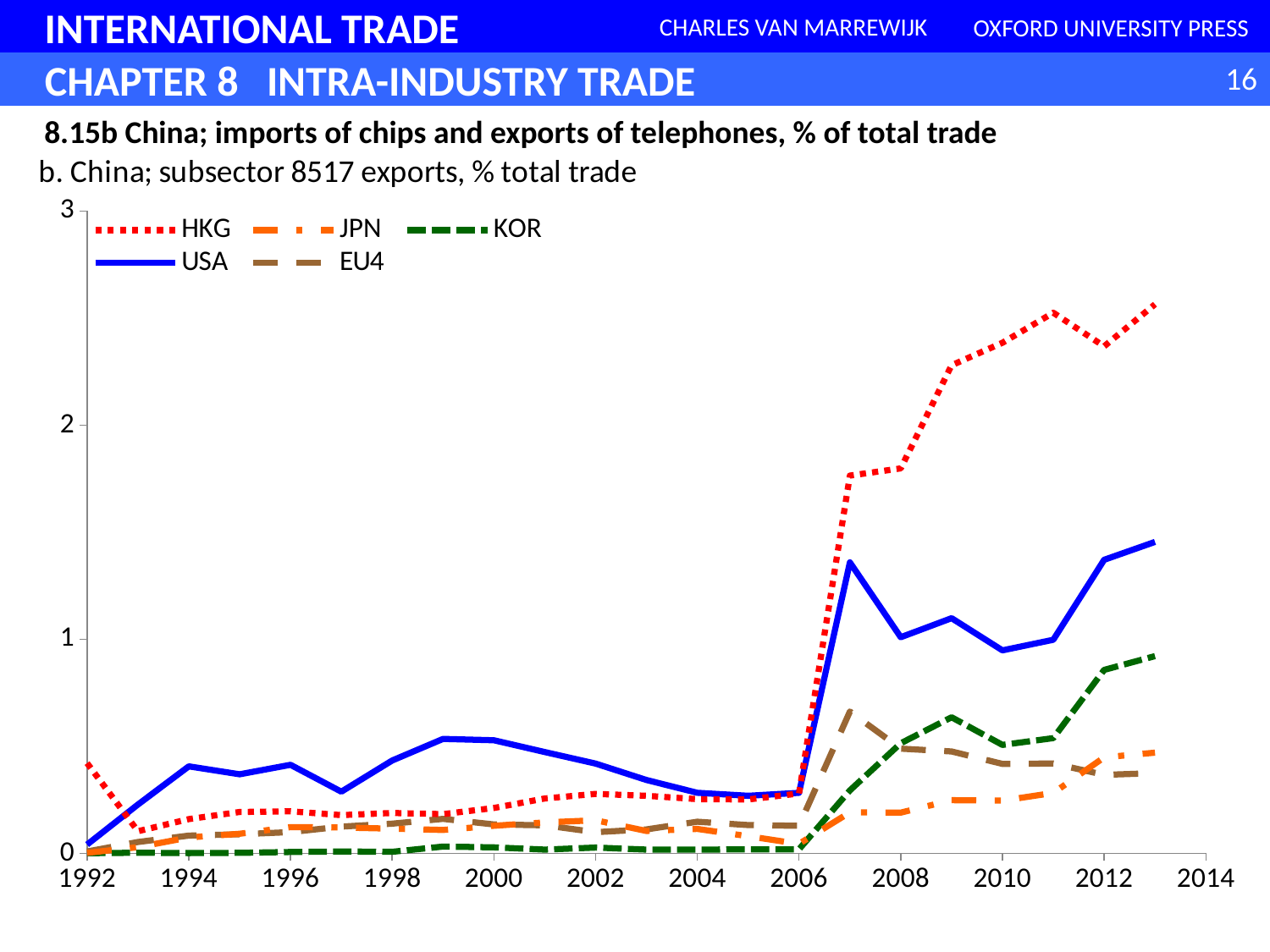
Does the HKG series rise or fall between 2006 and 2013? rise Which series has the highest value in 1999? USA What kind of chart is shown on the slide? line chart Which series has the lowest value in 2000? KOR Is the value for USA in 2013 greater or less than 1? greater Is the value for JPN in 2013 greater or less than 1? less Is the value for KOR in 2013 greater or less than 1? less What is the title printed directly above the chart? b. China; subsector 8517 exports, % total trade In 2008, which is larger, the value for HKG or the value for USA? HKG Which series has the highest value in 2013? HKG How many series does the legend list? 5